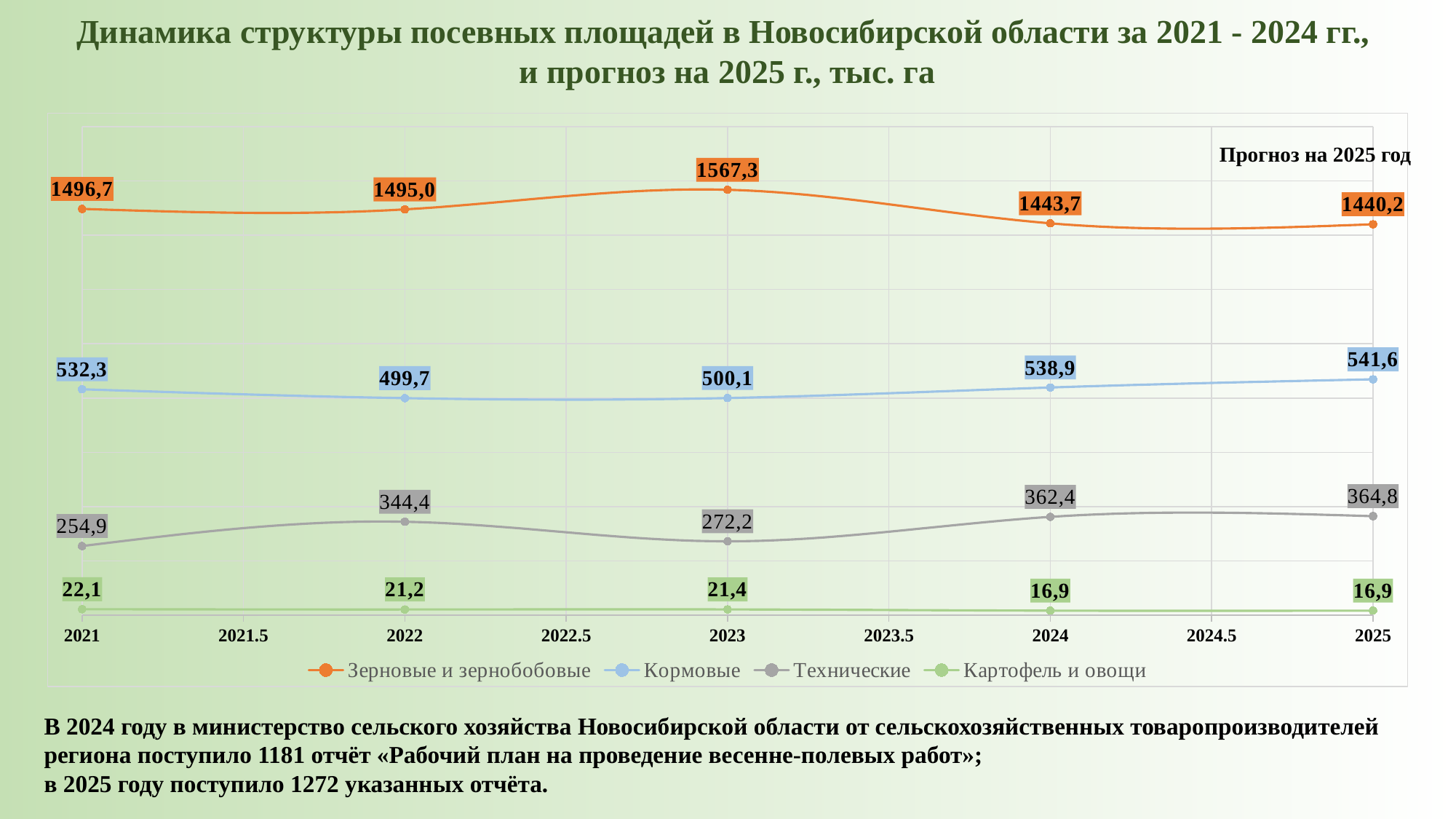
How many series does the legend list? 4 What is the value for Картофель и овощи in 2024? 16,9 Does the value for Картофель и овощи rise or fall from 2021 to 2025? Fall What kind of chart is shown on the slide? Line chart What is the difference between the Зерновые и зернобобовые values for 2023 and 2024? 123,6 What is the value for Технические in 2021? 254,9 What is the difference between the Технические values for 2022 and 2021? 89,5 Which is larger for Кормовые: the value in 2021 or the value in 2024? 2024 In which year is the value for Картофель и овощи the highest? 2021 In which year is the value for Зерновые и зернобобовые the highest? 2023 What is the value for Кормовые in 2025? 541,6 What is the value for Зерновые и зернобобовые in 2023? 1567,3